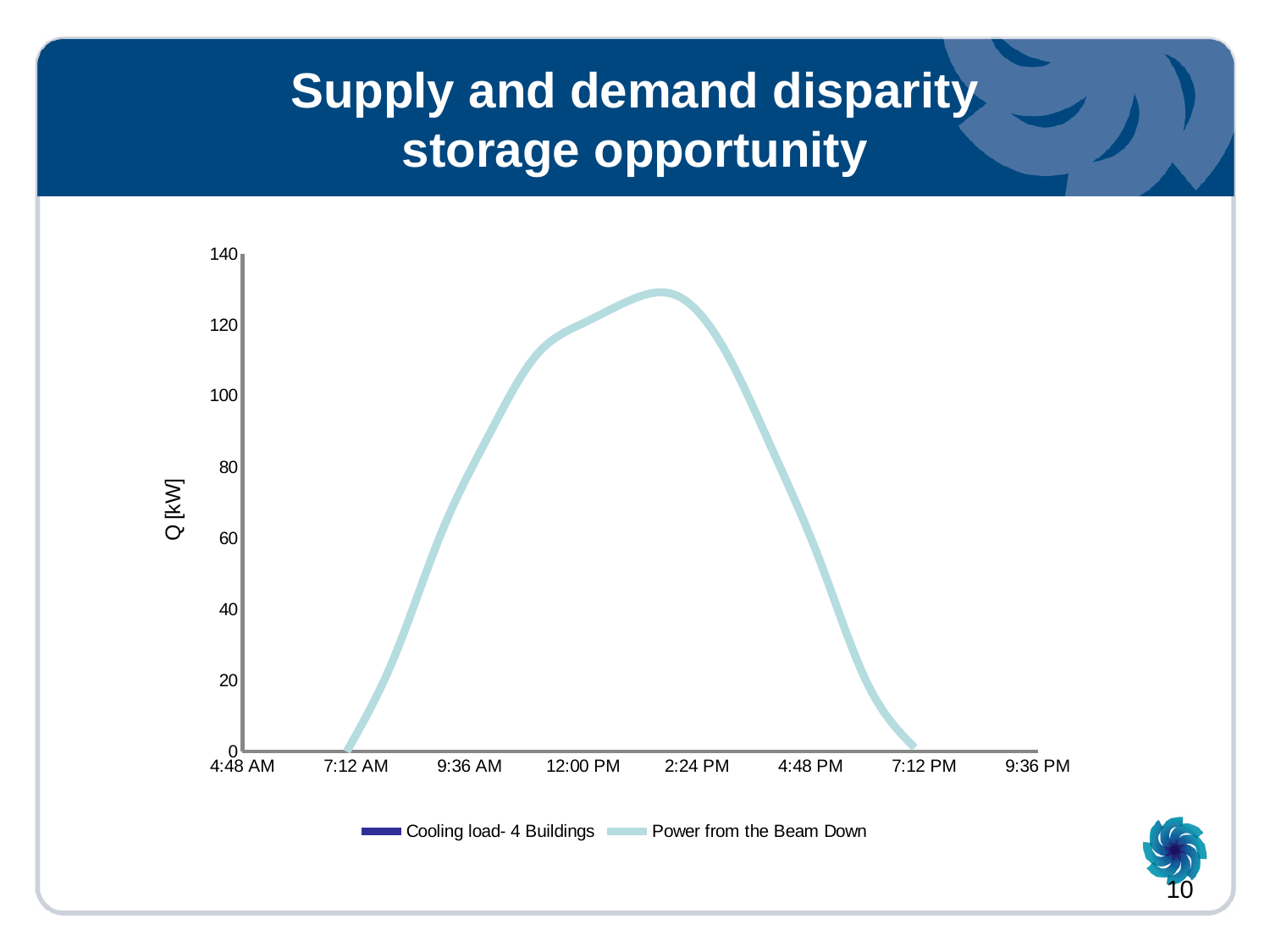
Is the peak value of Power from the Beam Down greater or less than 120? greater How many series does the legend list? 2 Is the value of Power from the Beam Down at 12:00 PM greater or less than 100? greater What is the label on the vertical axis? Q [kW] What kind of chart is shown on the slide? line chart Does Power from the Beam Down rise or fall between 7:12 AM and 12:00 PM? rise What is the title of the slide containing the chart? Supply and demand disparity storage opportunity What is the value of Power from the Beam Down at 7:12 PM? 0 Does Power from the Beam Down rise or fall between 2:24 PM and 7:12 PM? fall Is the peak value of Power from the Beam Down greater or less than 140? less What is the value of Power from the Beam Down at 7:12 AM? 0